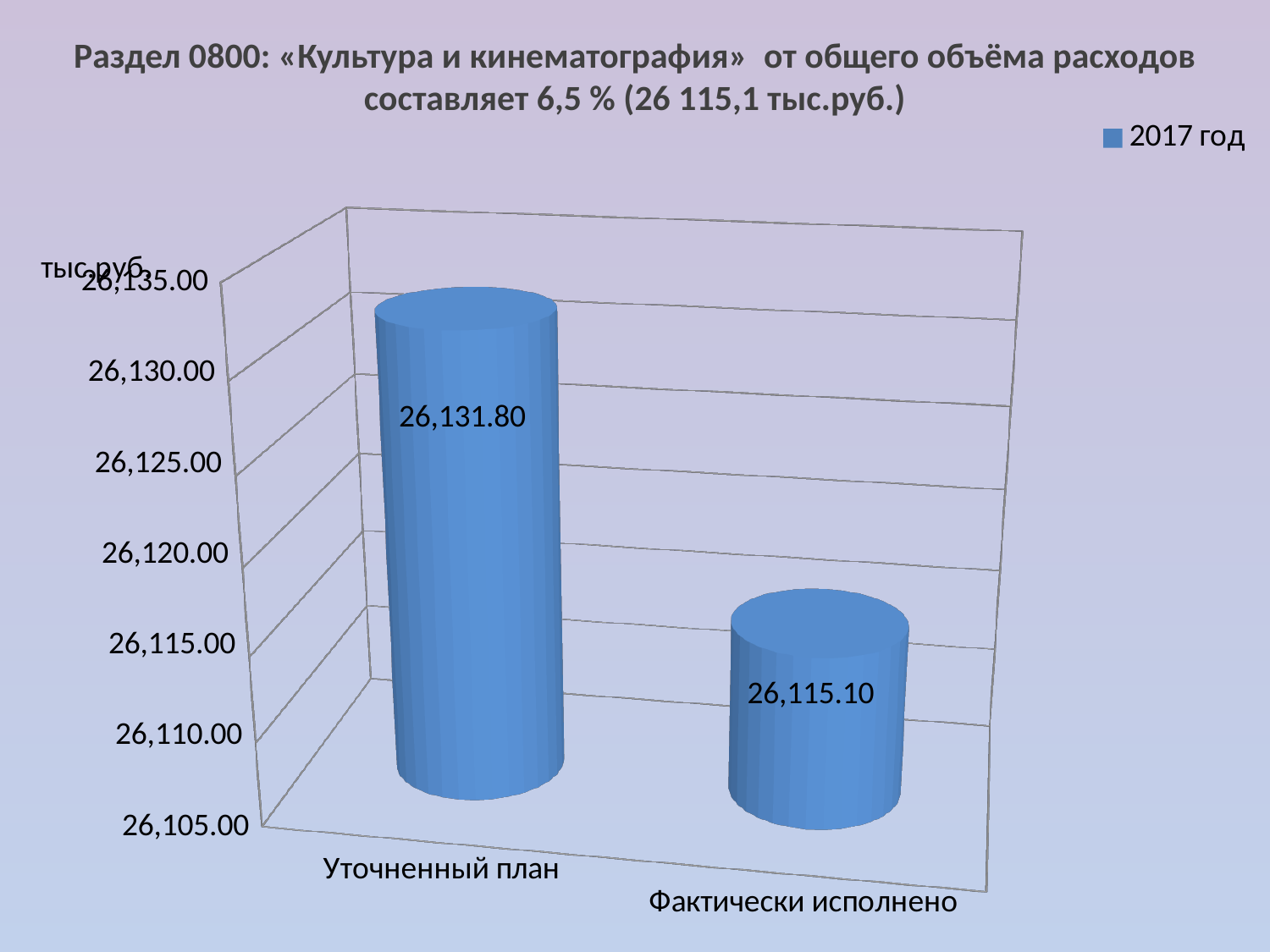
What kind of chart is shown on the slide? bar chart Which is larger, the value for Уточненный план or the value for Фактически исполнено? Уточненный план What is the difference between the values for Уточненный план and Фактически исполнено? 16.70 What is the value for Уточненный план? 26,131.80 How many series does the legend list? 1 What is the value for Фактически исполнено? 26,115.10 Which category has the highest value? Уточненный план Which category has the lowest value? Фактически исполнено Is the value for Уточненный план greater or less than 26,125.00? greater How many categories are shown on the chart? 2 Is the value for Фактически исполнено greater or less than 26,120.00? less What series name is shown in the legend? 2017 год